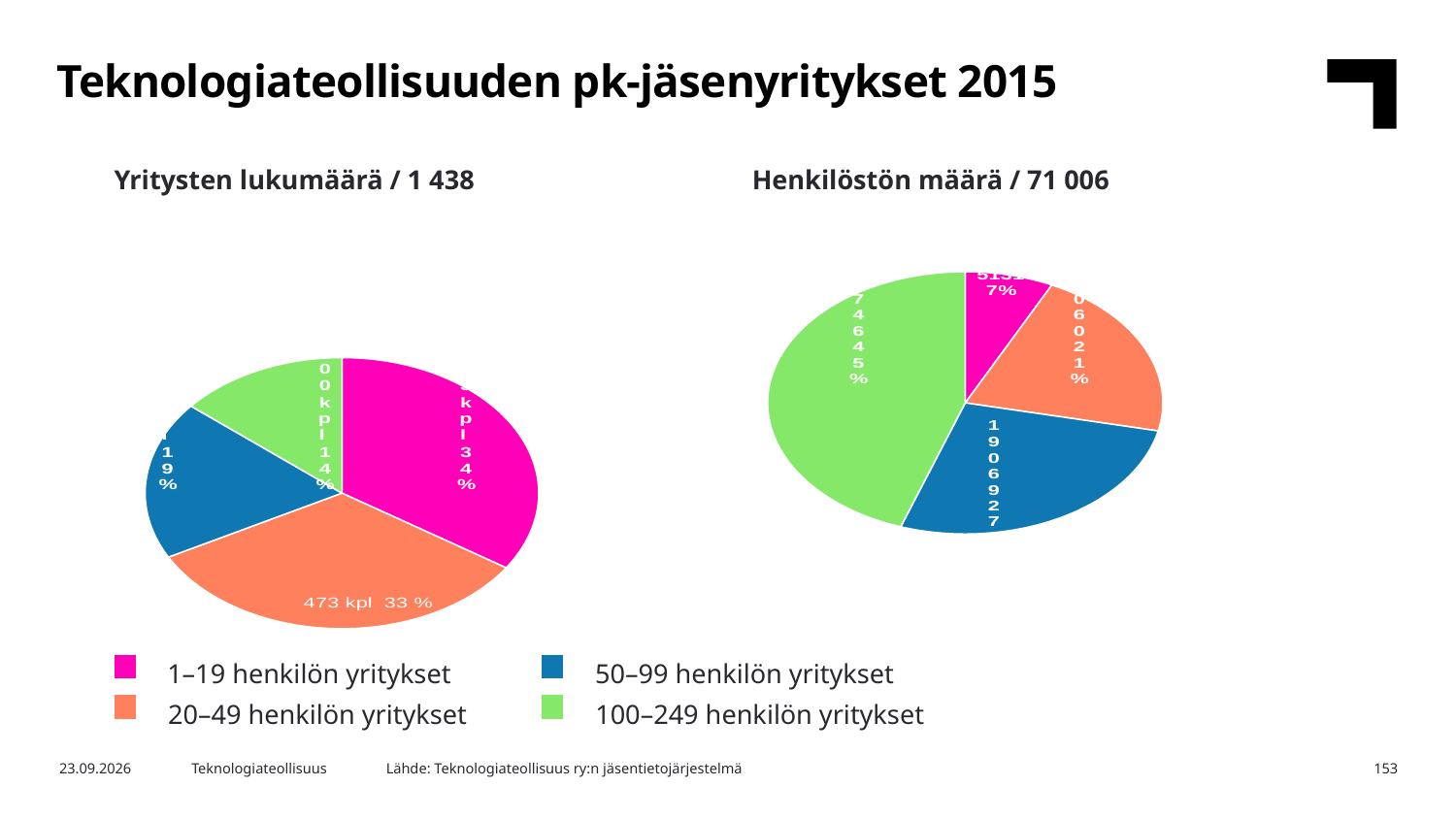
In the 'Yritysten lukumäärä / 1 438' chart, what share do the 50–99 henkilön yritykset have? 19% What kind of chart is used on this slide? Pie chart In the 'Yritysten lukumäärä / 1 438' chart, which slice is larger: 50–99 henkilön yritykset or 100–249 henkilön yritykset? 50–99 henkilön yritykset In the 'Yritysten lukumäärä / 1 438' chart, what share do the 20–49 henkilön yritykset have? 33 % In the 'Henkilöstön määrä / 71 006' chart, what share do the 1–19 henkilön yritykset have? 7% In the 'Henkilöstön määrä / 71 006' chart, which category has the largest slice? 100–249 henkilön yritykset In the 'Yritysten lukumäärä / 1 438' chart, how many companies are in the 20–49 henkilön yritykset slice? 473 kpl What total number of personnel is given in the title of the right-hand chart? 71 006 How many categories does the legend list? 4 In the 'Yritysten lukumäärä / 1 438' chart, which category has the smallest slice? 100–249 henkilön yritykset